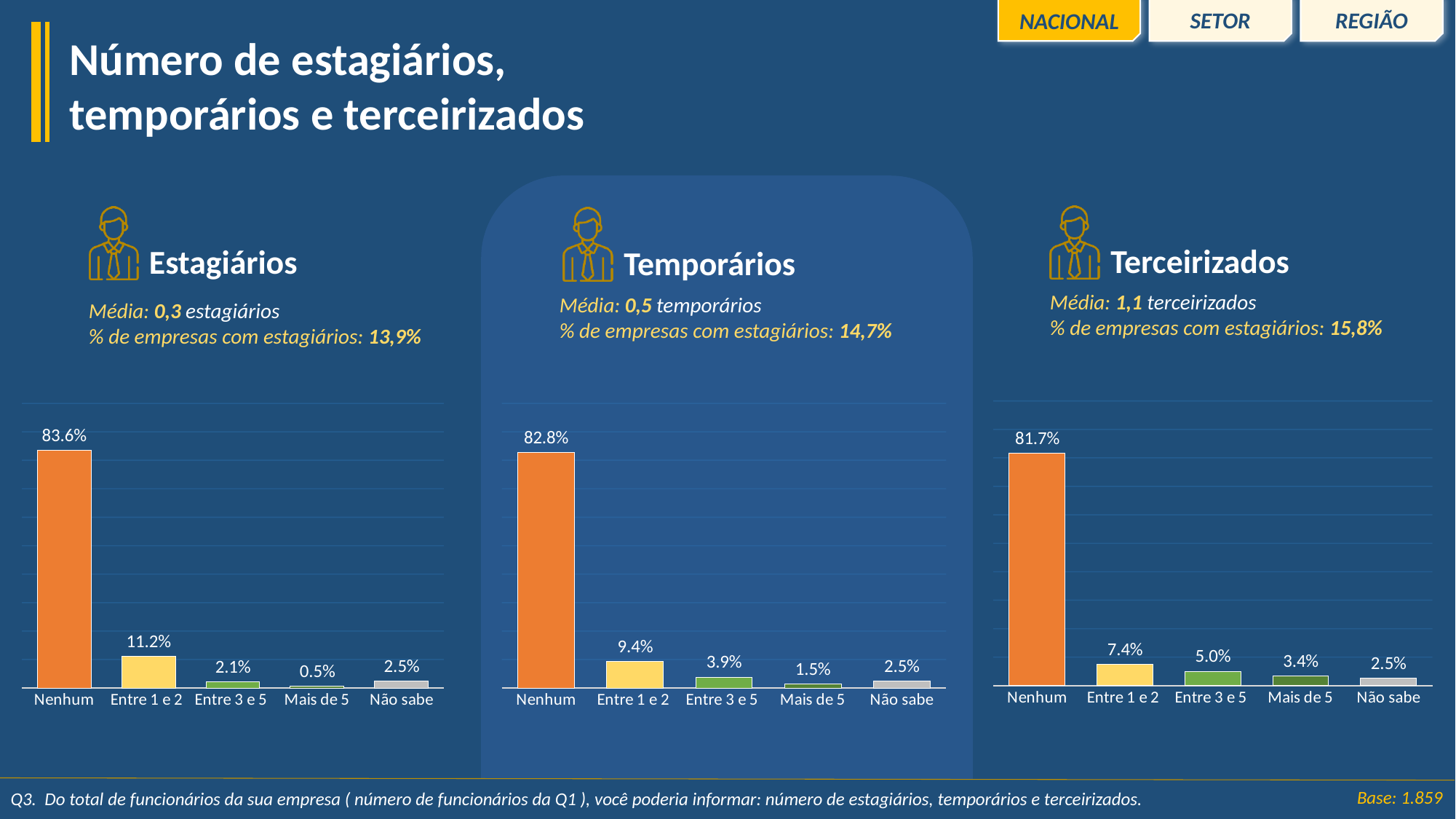
In the Terceirizados chart, which category has the highest value? Nenhum In the Terceirizados chart, which is larger: Mais de 5 or Não sabe? Mais de 5 In the Temporários chart, what is the value for Mais de 5? 1.5% In the Estagiários chart, how many categories are shown? 5 In the Estagiários chart, what is the difference between Nenhum and Entre 1 e 2? 72.4% How many charts are on the slide? 3 In the Estagiários chart, which category has the lowest value? Mais de 5 In the Temporários chart, what is the value for Entre 1 e 2? 9.4% What kind of chart is the Temporários chart? Bar chart In the Terceirizados chart, what is the value for Entre 3 e 5? 5.0% In the Temporários chart, what is the difference between Entre 1 e 2 and Entre 3 e 5? 5.5% In the Estagiários chart, what is the value for Nenhum? 83.6%